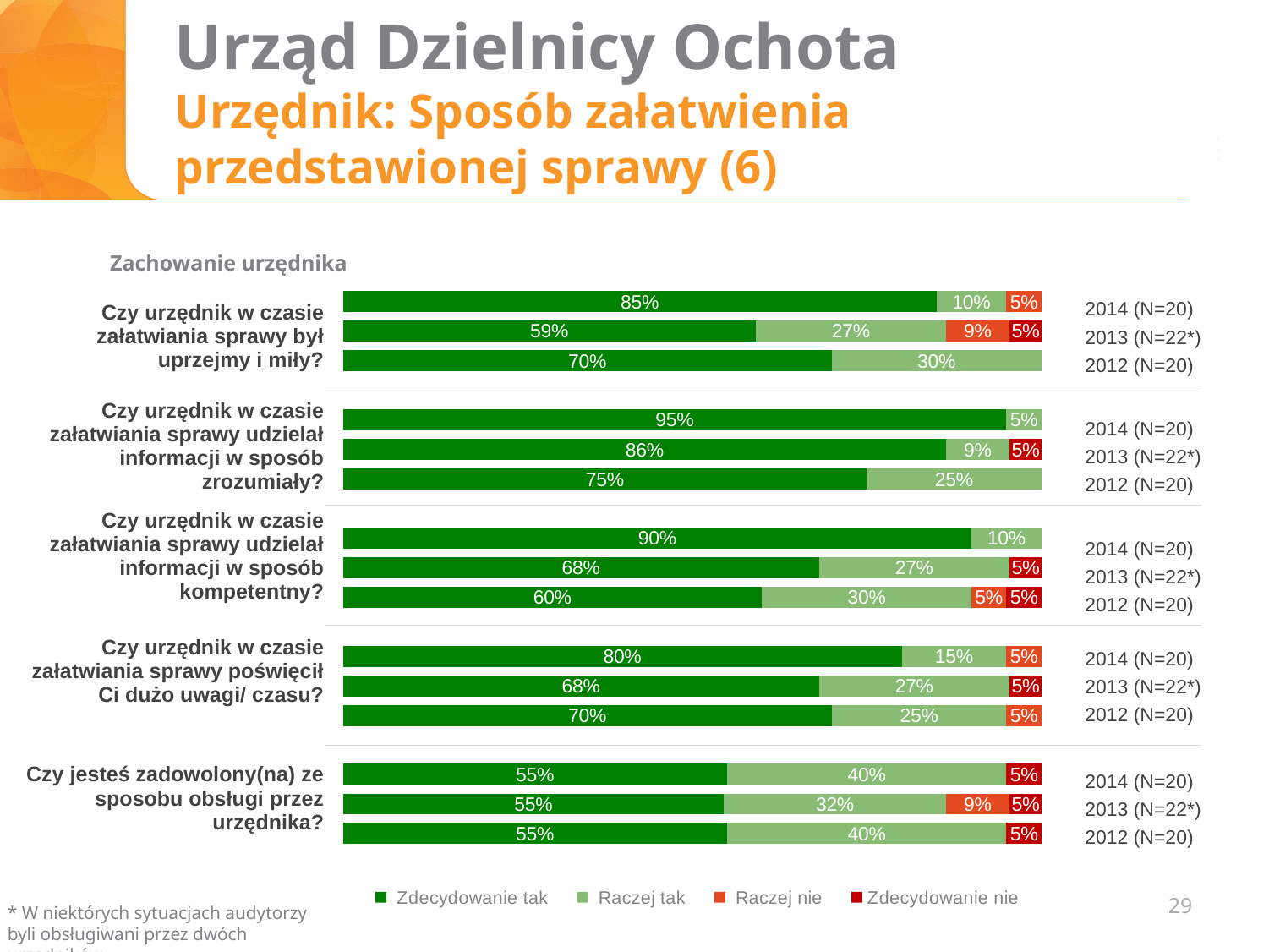
For "Czy urzędnik w czasie załatwiania sprawy udzielał informacji w sposób zrozumiały?", which year has the highest "Zdecydowanie tak" share? 2014 What percentage answered "Raczej tak" in 2012 to "Czy urzędnik w czasie załatwiania sprawy udzielał informacji w sposób zrozumiały?" 25% For "Czy urzędnik w czasie załatwiania sprawy udzielał informacji w sposób kompetentny?", which year has the larger "Zdecydowanie tak" share, 2013 or 2012? 2013 What are the four legend entries of the chart? Zdecydowanie tak, Raczej tak, Raczej nie, Zdecydowanie nie What percentage answered "Zdecydowanie tak" in 2014 to "Czy urzędnik w czasie załatwiania sprawy był uprzejmy i miły?" 85% What is the difference in the "Zdecydowanie tak" share between 2014 and 2013 for "Czy urzędnik w czasie załatwiania sprawy był uprzejmy i miły?" 26 percentage points What percentage answered "Raczej tak" in 2014 to "Czy jesteś zadowolony(na) ze sposobu obsługi przez urzędnika?" 40% How many response categories does the legend list? 4 How does the "Zdecydowanie tak" share for "Czy jesteś zadowolony(na) ze sposobu obsługi przez urzędnika?" change from 2012 to 2014? It stays the same at 55% What kind of chart is shown on the slide? Stacked bar chart How many years are shown for each question in the chart? 3 What percentage answered "Raczej tak" in 2014 to "Czy urzędnik w czasie załatwiania sprawy poświęcił Ci dużo uwagi/ czasu?" 15%